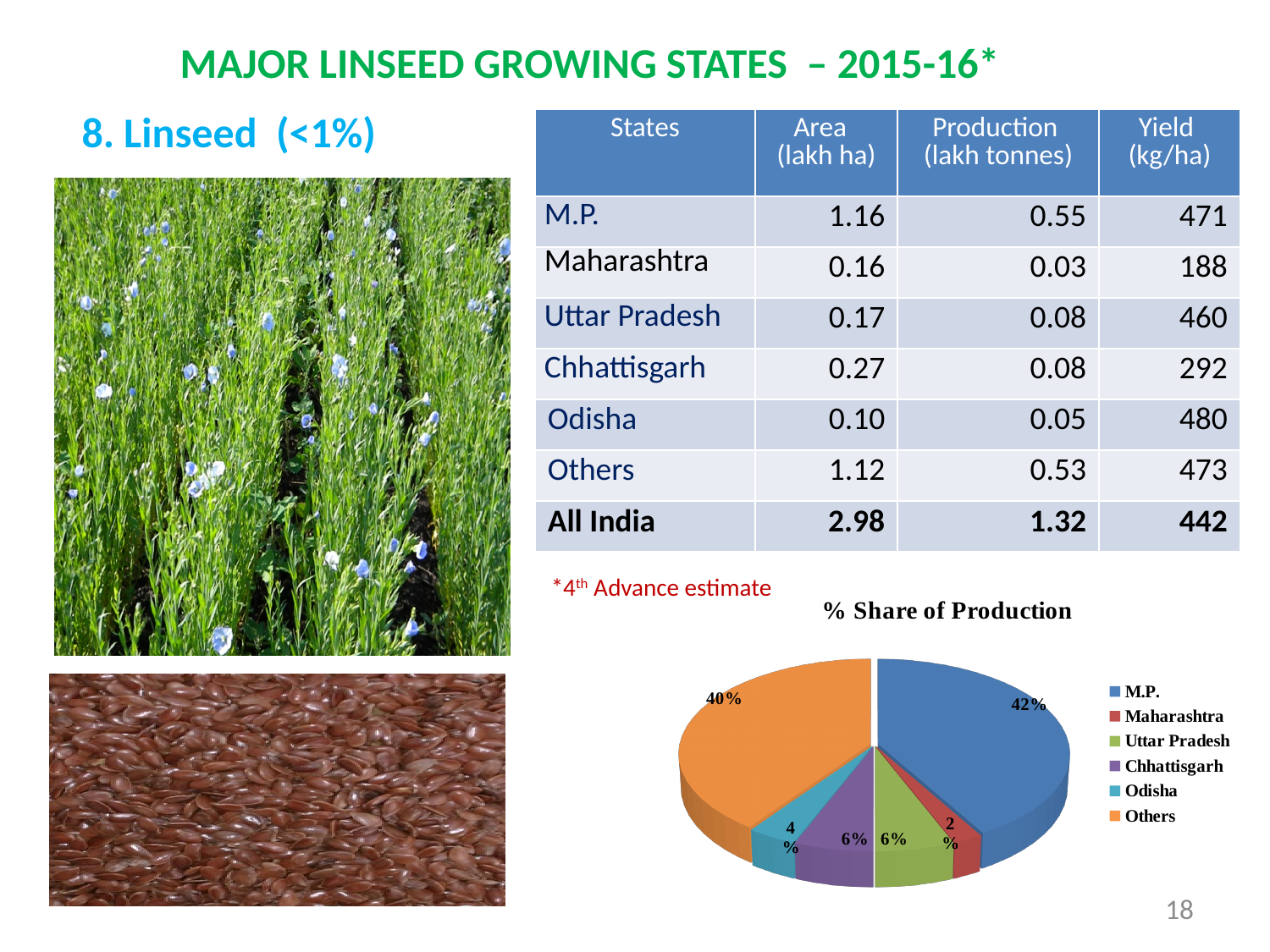
What is the share of production for M.P. in the pie chart? 42% What is the share of production for Uttar Pradesh in the pie chart? 6% Which has a larger share of production in the pie chart, Odisha or Chhattisgarh? Chhattisgarh What is the share of production for Maharashtra in the pie chart? 2% Which state has the largest share of production in the pie chart? M.P. What is the share of production for Odisha in the pie chart? 4% What is the share of production for Others in the pie chart? 40% How many slices does the pie chart have? 6 What type of chart is shown on the slide? Pie chart Which state has the smallest share of production in the pie chart? Maharashtra What is the difference in percentage points between the shares of M.P. and Others in the pie chart? 2 What is the title of the chart on the slide? % Share of Production